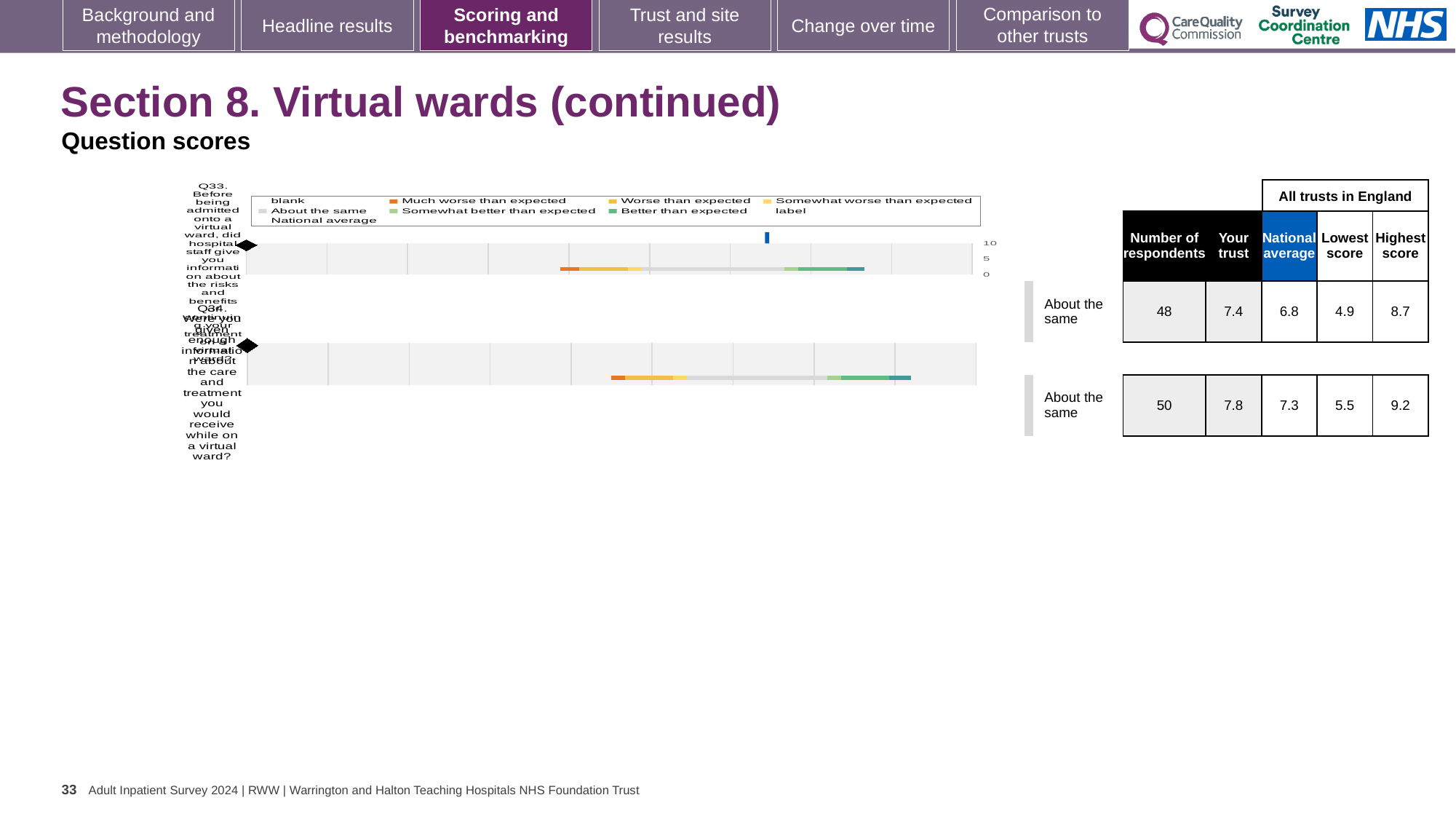
What is the national average score for Q33? 6.8 Which question has the higher 'Your trust' score, Q33 or Q34? Q34 What is the lowest score among all trusts in England for Q34? 5.5 What is the 'Your trust' score for Q33? 7.4 What colour does the legend use for 'Much worse than expected'? orange What is the difference between the 'Your trust' score and the national average for Q34? 0.5 How many respondents answered Q34? 50 What type of chart is used to show the question scores for Q33 and Q34? bar chart What is the 'Your trust' score for Q34? 7.8 What is the highest score among all trusts in England for Q33? 8.7 What benchmark category is shown next to the Q33 bar? About the same How many questions (bars) are plotted in the chart? 2